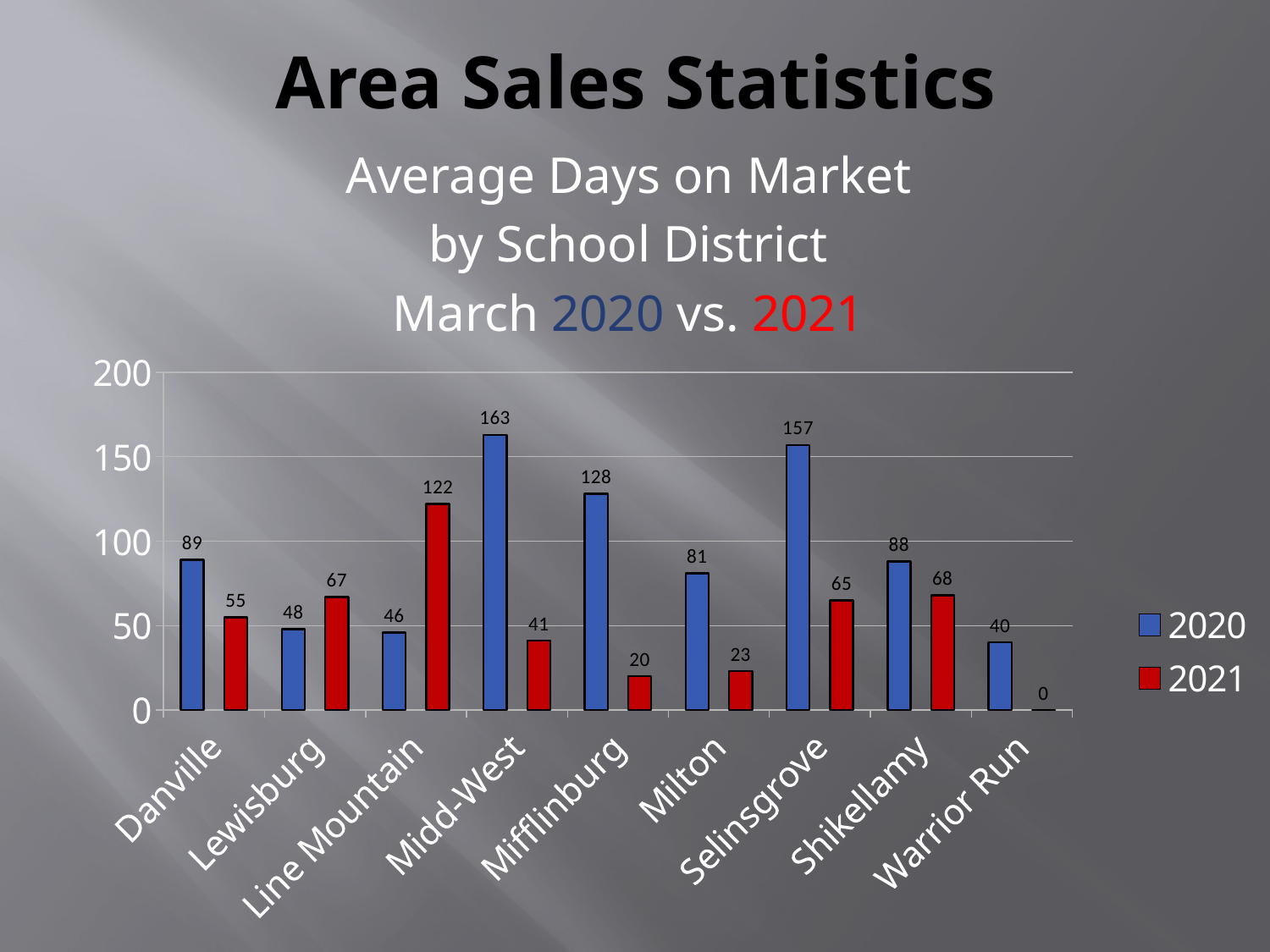
What was the average days on market for Danville in 2020? 89 What is the difference between the 2020 and 2021 values for Mifflinburg? 108 Which school district had the highest average days on market in 2020? Midd-West What was the average days on market for Line Mountain in 2021? 122 How many school districts are shown on the x axis? 9 How many series does the legend list? 2 Which is larger for Lewisburg, the 2020 value or the 2021 value? 2021 What was the average days on market for Warrior Run in 2021? 0 Which school district had the lowest average days on market in 2021? Warrior Run Is the 2020 value for Selinsgrove greater or less than 150? greater Which colour represents the 2021 series in the chart? red What kind of chart is shown on the slide? bar chart